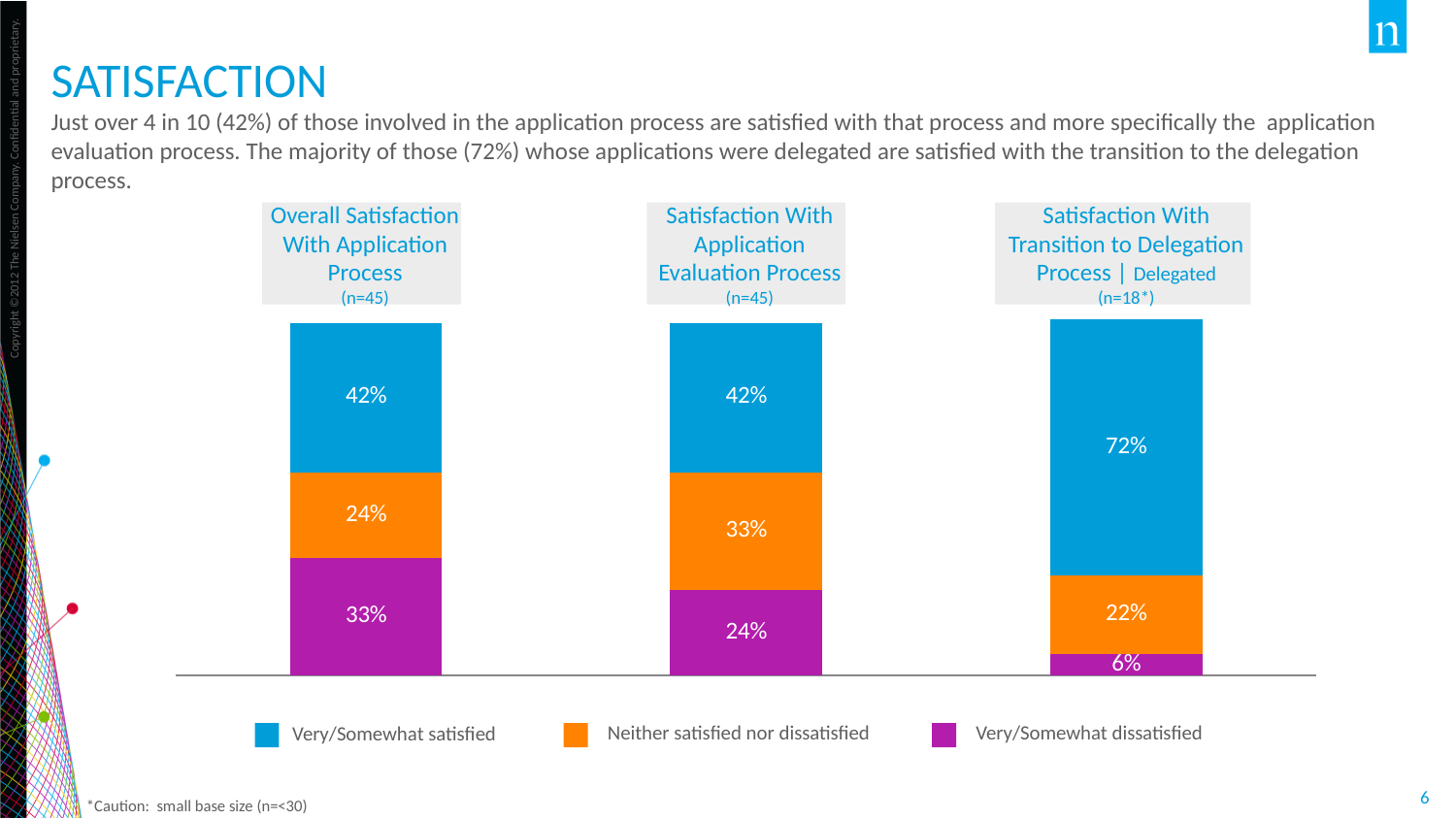
Which process has the highest Very/Somewhat satisfied percentage? Satisfaction With Transition to Delegation Process What is the difference between the Very/Somewhat satisfied percentage for the Transition to Delegation Process and the Overall Satisfaction With Application Process? 30% Which is larger: the Neither satisfied nor dissatisfied percentage for the Application Evaluation Process or for the Overall Application Process? Application Evaluation Process What percentage are Very/Somewhat satisfied with the Overall Satisfaction With Application Process? 42% Which process has the lowest Very/Somewhat dissatisfied percentage? Satisfaction With Transition to Delegation Process What is the total of the stacked bar for the Satisfaction With Transition to Delegation Process? 100% What kind of chart is shown on the slide? Stacked bar chart What percentage are Neither satisfied nor dissatisfied with the Satisfaction With Transition to Delegation Process? 22% How many stacked bars are shown on the chart? 3 How many series does the legend list? 3 What is the sample size shown for the Satisfaction With Transition to Delegation Process bar? n=18* What percentage are Very/Somewhat dissatisfied with the Satisfaction With Application Evaluation Process? 24%